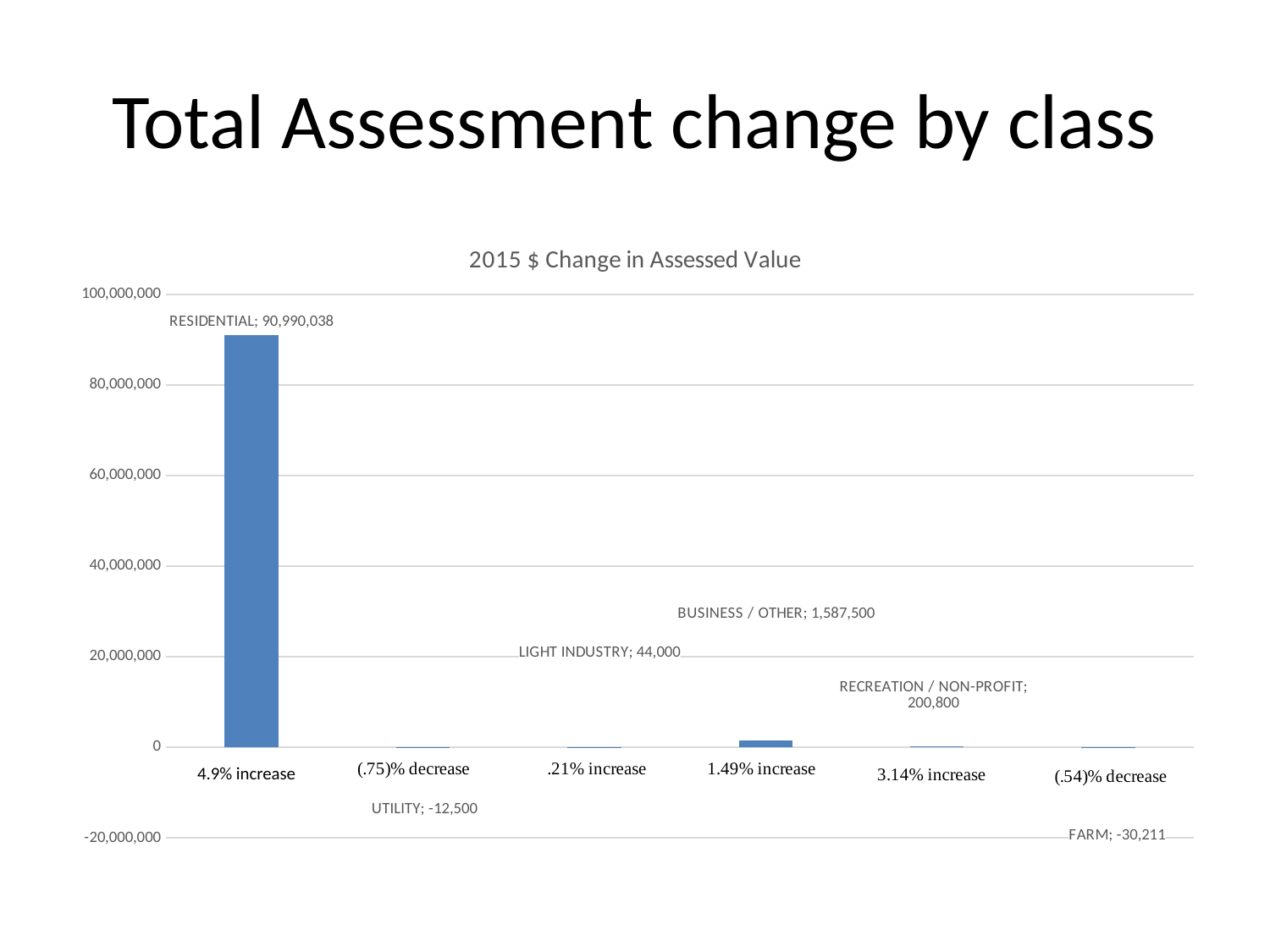
What is the difference between the values for BUSINESS / OTHER and RECREATION / NON-PROFIT? 1,386,700 What is the value for BUSINESS / OTHER in the chart? 1,587,500 Which category has the highest value in the chart? RESIDENTIAL What is the value for UTILITY in the chart? -12,500 Which category has the lowest value in the chart? FARM What is the value for RESIDENTIAL in the 2015 $ Change in Assessed Value chart? 90,990,038 Which is larger, the value for LIGHT INDUSTRY or the value for RECREATION / NON-PROFIT? RECREATION / NON-PROFIT What kind of chart is shown on the slide? bar chart Is the value for RESIDENTIAL greater or less than 80,000,000? greater What is the title of the chart on the slide? 2015 $ Change in Assessed Value What is the value for FARM in the chart? -30,211 How many categories are shown in the chart? 6